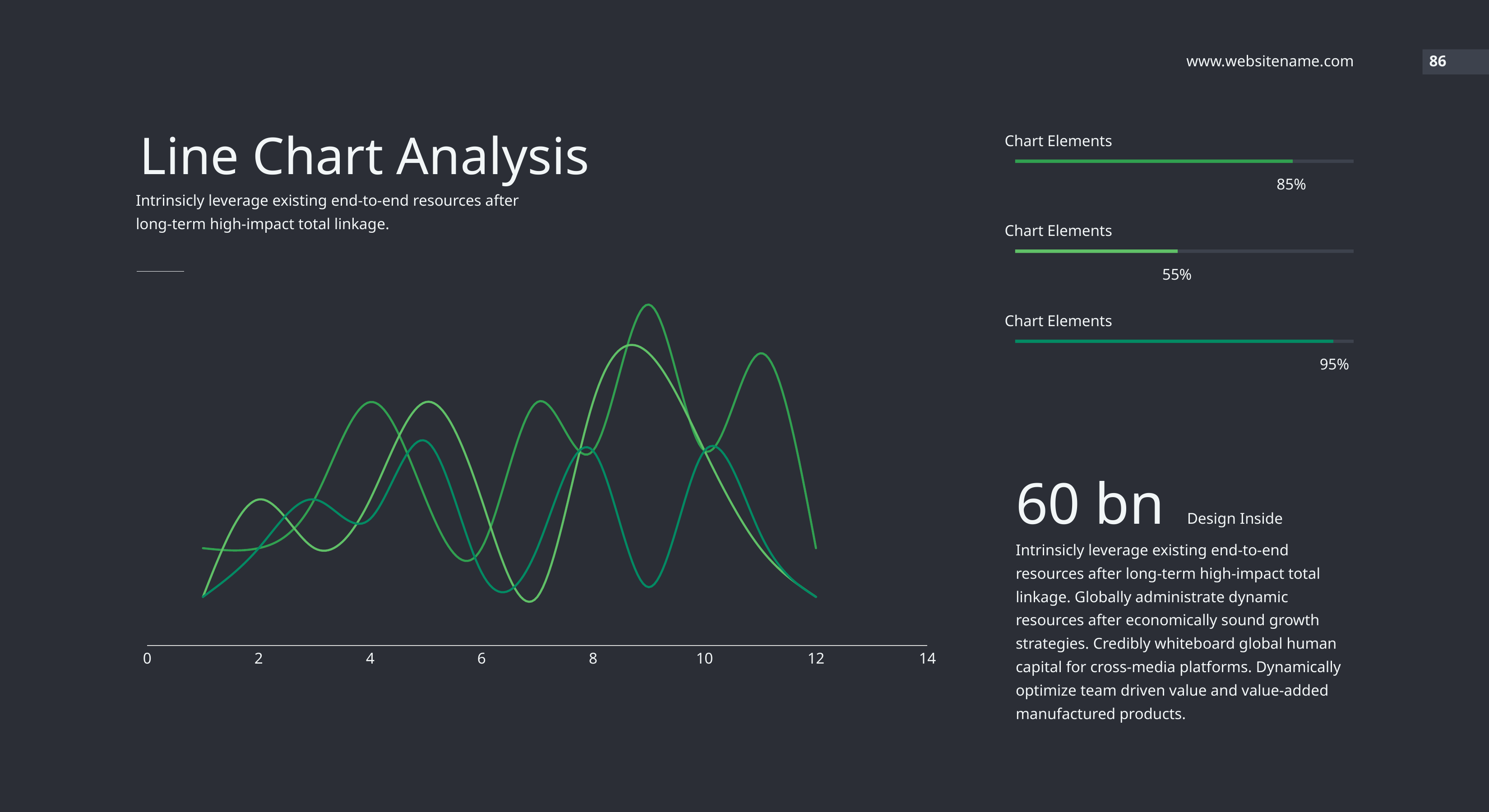
What is the interval between consecutive tick labels on the x axis of the line chart? 2 Does the line chart show a labeled vertical axis? No How many lines are plotted on the line chart? 3 What is the title of the slide containing the line chart? Line Chart Analysis At which x-axis tick value do the plotted lines end? 12 What kind of chart is shown on the slide? line chart Does the line chart display a legend? No How many tick labels are shown on the x axis of the line chart? 8 What is the lowest value labeled on the x axis of the line chart? 0 What is the highest value labeled on the x axis of the line chart? 14